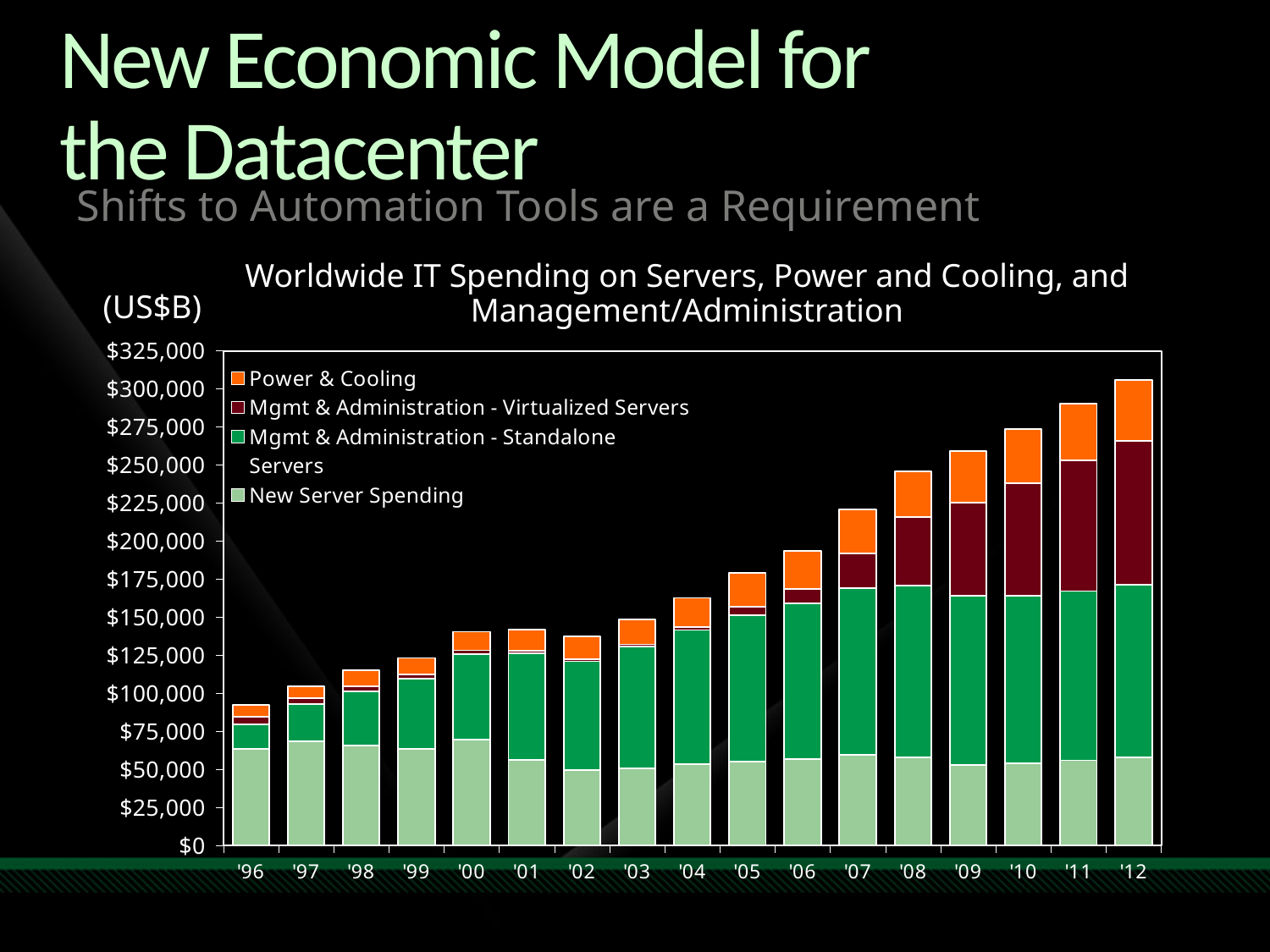
Is the New Server Spending segment for '12 greater or less than $75,000? less Is the total bar for '07 greater or less than $200,000? greater Which year has the lowest total stacked bar? '96 How many series does the chart's legend list? 4 What is the title of the chart? Worldwide IT Spending on Servers, Power and Cooling, and Management/Administration How many years are plotted along the x axis of the chart? 17 Which year has the larger total bar, '96 or '97? '97 Is the total bar for '12 greater or less than $275,000? greater Which year has the highest total stacked bar? '12 Do the total bars generally rise or fall from '96 to '12? Rise What kind of chart is shown on the slide? Stacked bar chart